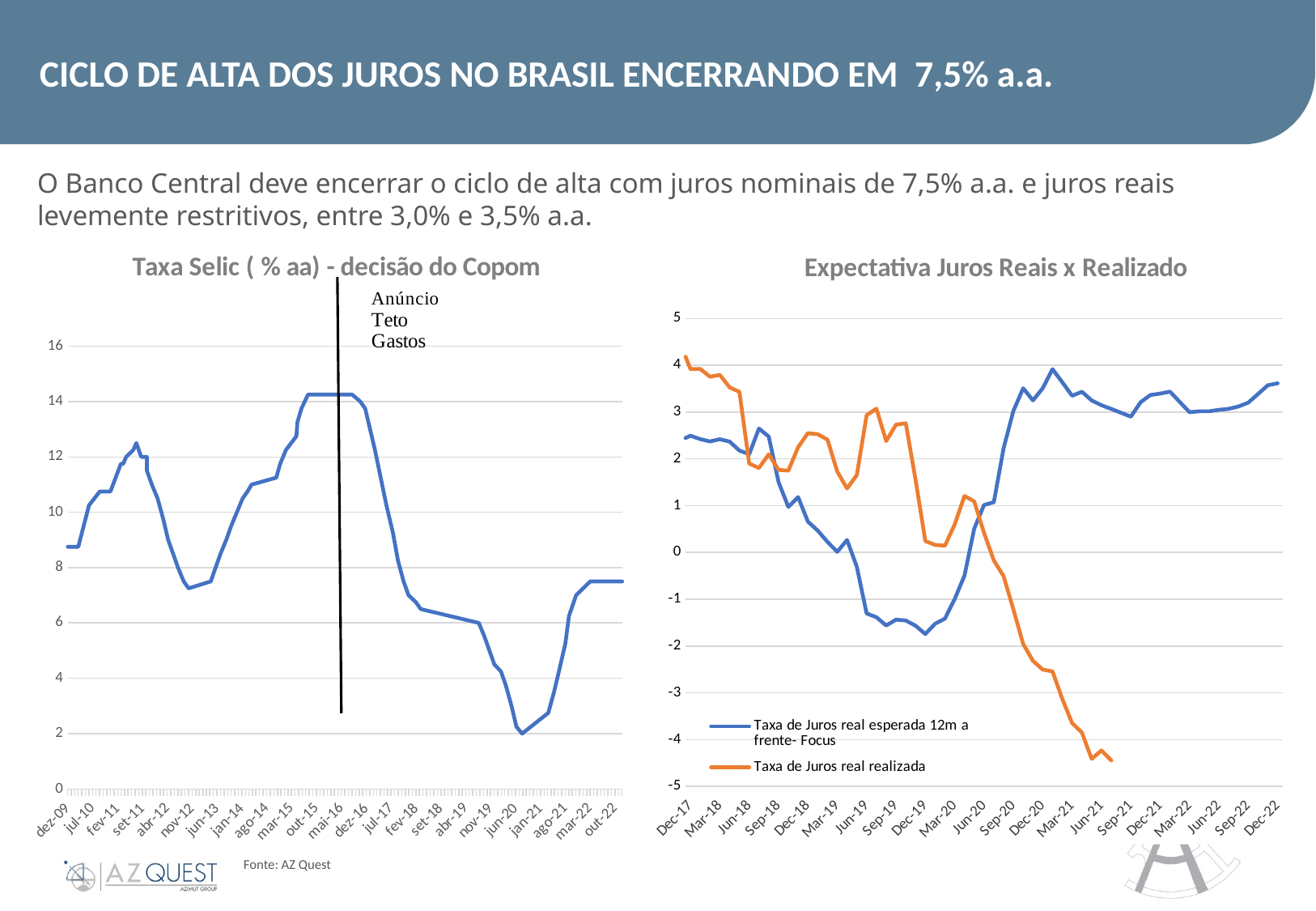
In the right chart "Expectativa Juros Reais x Realizado", is the value of "Taxa de Juros real esperada 12m a frente- Focus" at Dec-19 greater or less than -1? less In the left chart "Taxa Selic ( % aa) - decisão do Copom", what event does the vertical black line mark? Anúncio Teto Gastos In the right chart "Expectativa Juros Reais x Realizado", is the value of "Taxa de Juros real esperada 12m a frente- Focus" at Mar-21 greater or less than 3? greater In the left chart "Taxa Selic ( % aa) - decisão do Copom", is the value at out-15 greater or less than 14? greater In the right chart "Expectativa Juros Reais x Realizado", does "Taxa de Juros real realizada" rise or fall between Sep-19 and Jun-21? fall In the right chart "Expectativa Juros Reais x Realizado", how many series does the legend list? 2 What kind of chart is the left chart titled "Taxa Selic ( % aa) - decisão do Copom"? line chart In the left chart "Taxa Selic ( % aa) - decisão do Copom", does the Selic rate rise or fall between mai-16 and jan-20? fall In the right chart "Expectativa Juros Reais x Realizado", which series has the higher value at Dec-20? Taxa de Juros real esperada 12m a frente- Focus